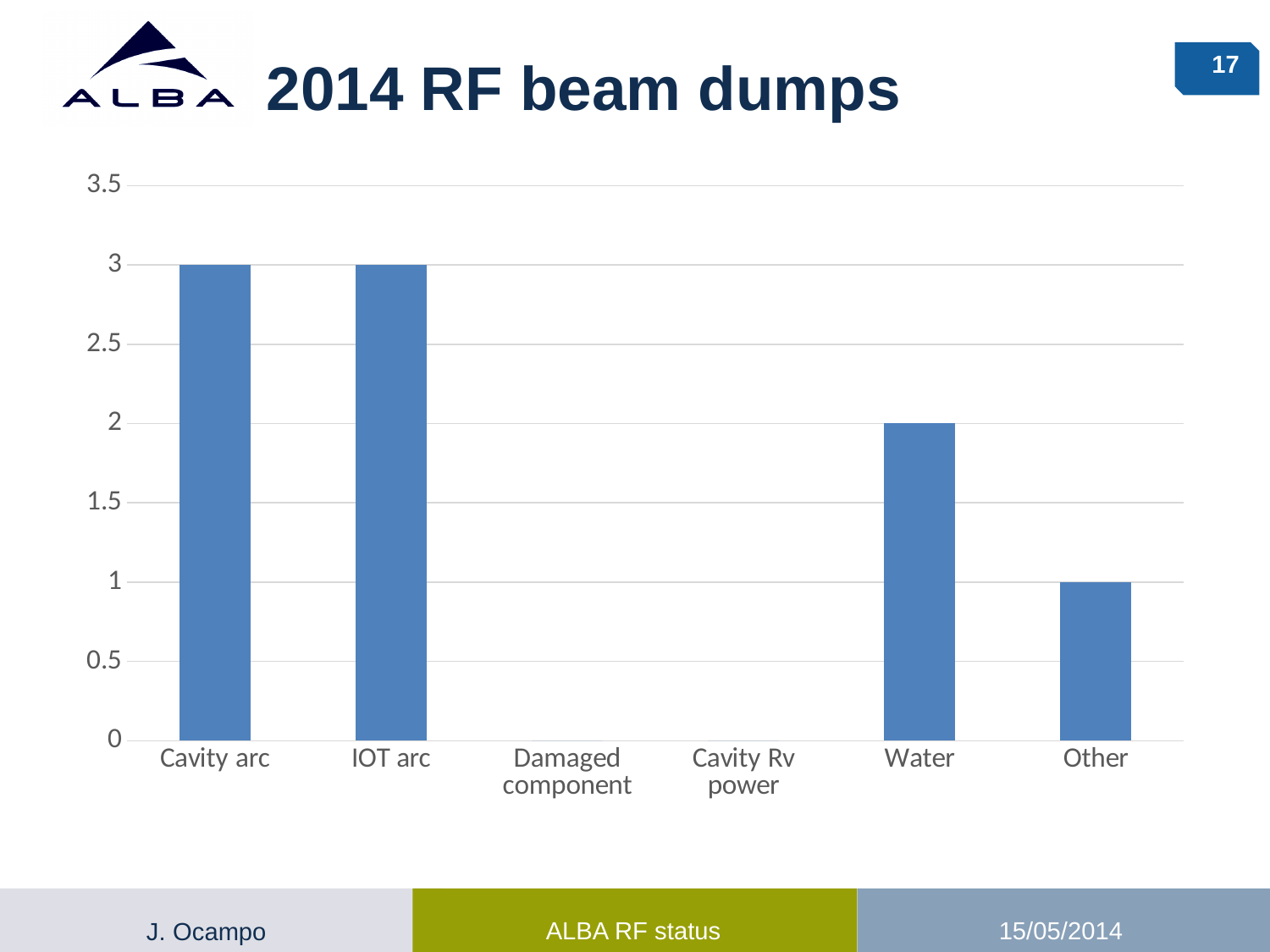
Is the value for Water greater or less than 1.5? greater What is the value for Water? 2 Which is larger, the value for Water or the value for Other? Water What is the value for Damaged component? 0 What is the difference between the value for IOT arc and the value for Other? 2 What is the value for Other? 1 What is the value for IOT arc? 3 How many categories are shown on the x axis? 6 What kind of chart is shown on the slide? bar chart What is the value for Cavity arc? 3 What is the difference between the value for Cavity arc and the value for Water? 1 Which is larger, the value for Cavity arc or the value for Water? Cavity arc